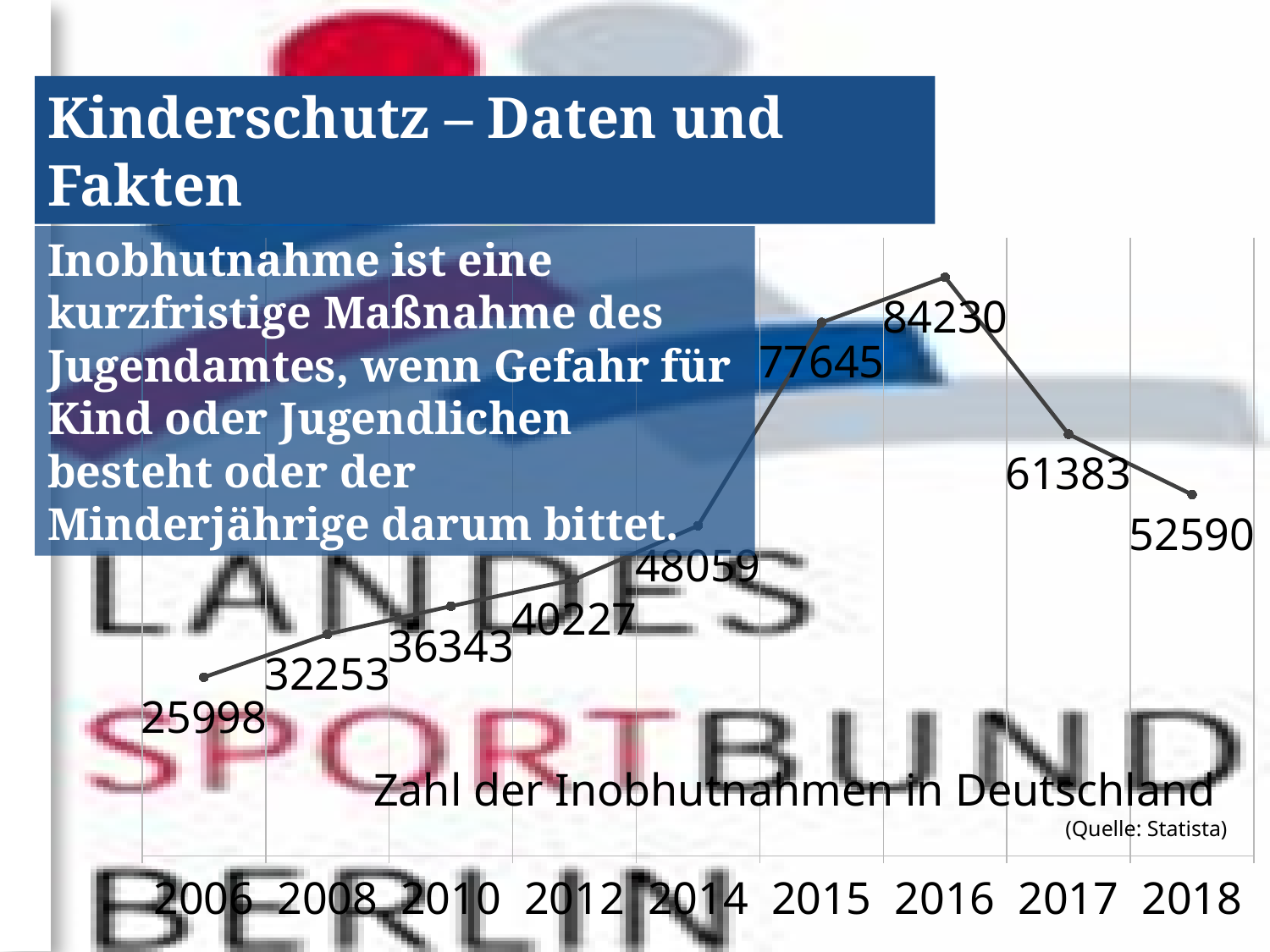
What is the difference between the values for 2015 and 2014? 29586 What is the difference between the values for 2016 and 2017? 22847 What is the value for 2006 in the chart 'Zahl der Inobhutnahmen in Deutschland'? 25998 Which year has the lowest value in the chart? 2006 What kind of chart is shown on the slide? line chart What is the title of the chart on the slide? Zahl der Inobhutnahmen in Deutschland Which is larger, the value for 2017 or the value for 2018? 2017 What is the value for 2018 in the chart? 52590 What is the value for 2014 in the chart? 48059 What is the value for 2016 in the chart? 84230 Which year has the highest value in the chart? 2016 How many data points are plotted in the chart? 9